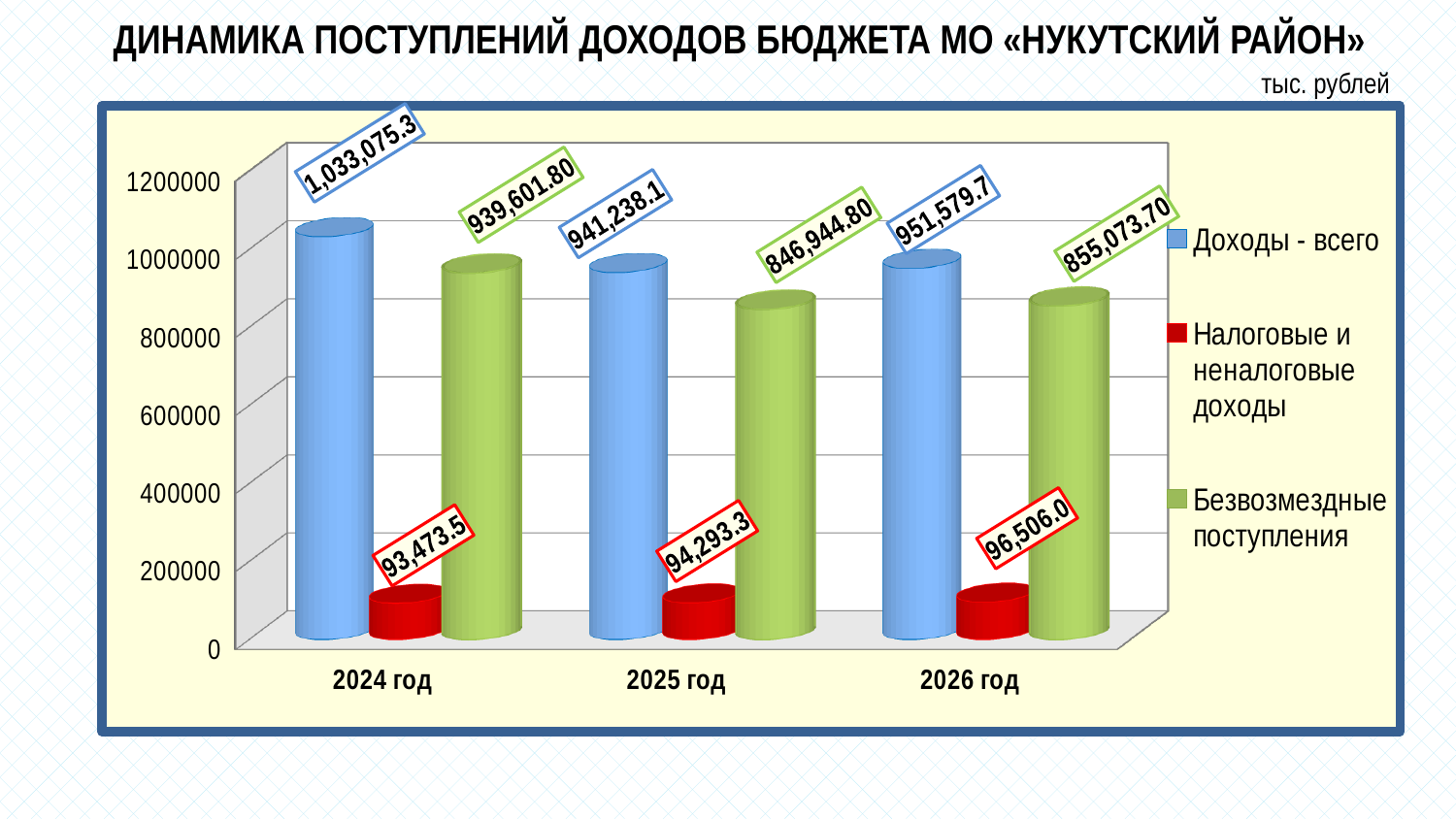
What is the difference between Безвозмездные поступления in 2026 год and in 2025 год? 8,128.90 What is the value for Безвозмездные поступления in 2025 год? 846,944.80 Which is larger: Доходы - всего in 2025 год or in 2026 год? 2026 год In which year is Доходы - всего highest? 2024 год What kind of chart is shown on the slide? bar chart What is the value for Доходы - всего in 2024 год? 1,033,075.3 Do the values for Налоговые и неналоговые доходы rise or fall from 2024 год to 2026 год? rise What is the difference between Доходы - всего in 2024 год and in 2025 год? 91,837.2 What is the value for Налоговые и неналоговые доходы in 2026 год? 96,506.0 Is the value for Безвозмездные поступления in 2024 год greater or less than 800000? greater How many series does the legend list? 3 In which year is Налоговые и неналоговые доходы lowest? 2024 год